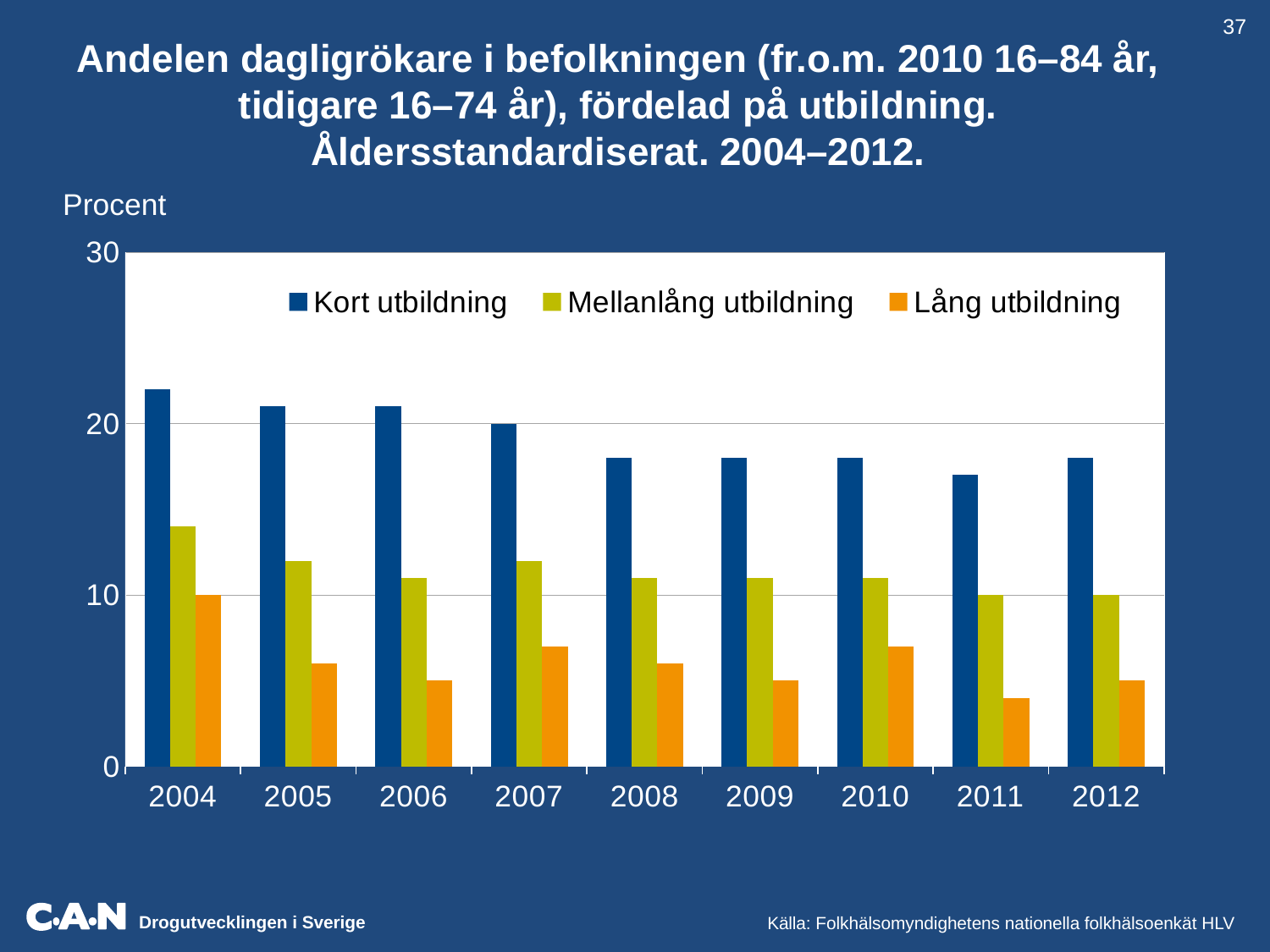
In which year is the value for Kort utbildning highest? 2004 How many years are shown on the x axis? 9 How many series does the legend list? 3 Is the value for Kort utbildning in 2004 greater or less than 20? greater Is the value for Mellanlång utbildning in 2004 greater or less than 10? greater What kind of chart is shown on the slide? Bar chart Which is larger: the value for Kort utbildning in 2004 or in 2011? 2004 What label is shown above the y axis? Procent Does the value for Kort utbildning generally rise or fall from 2004 to 2012? fall Is the value for Lång utbildning in 2006 greater or less than 10? less Which is larger in 2004: Mellanlång utbildning or Lång utbildning? Mellanlång utbildning In which year is the value for Lång utbildning lowest? 2011